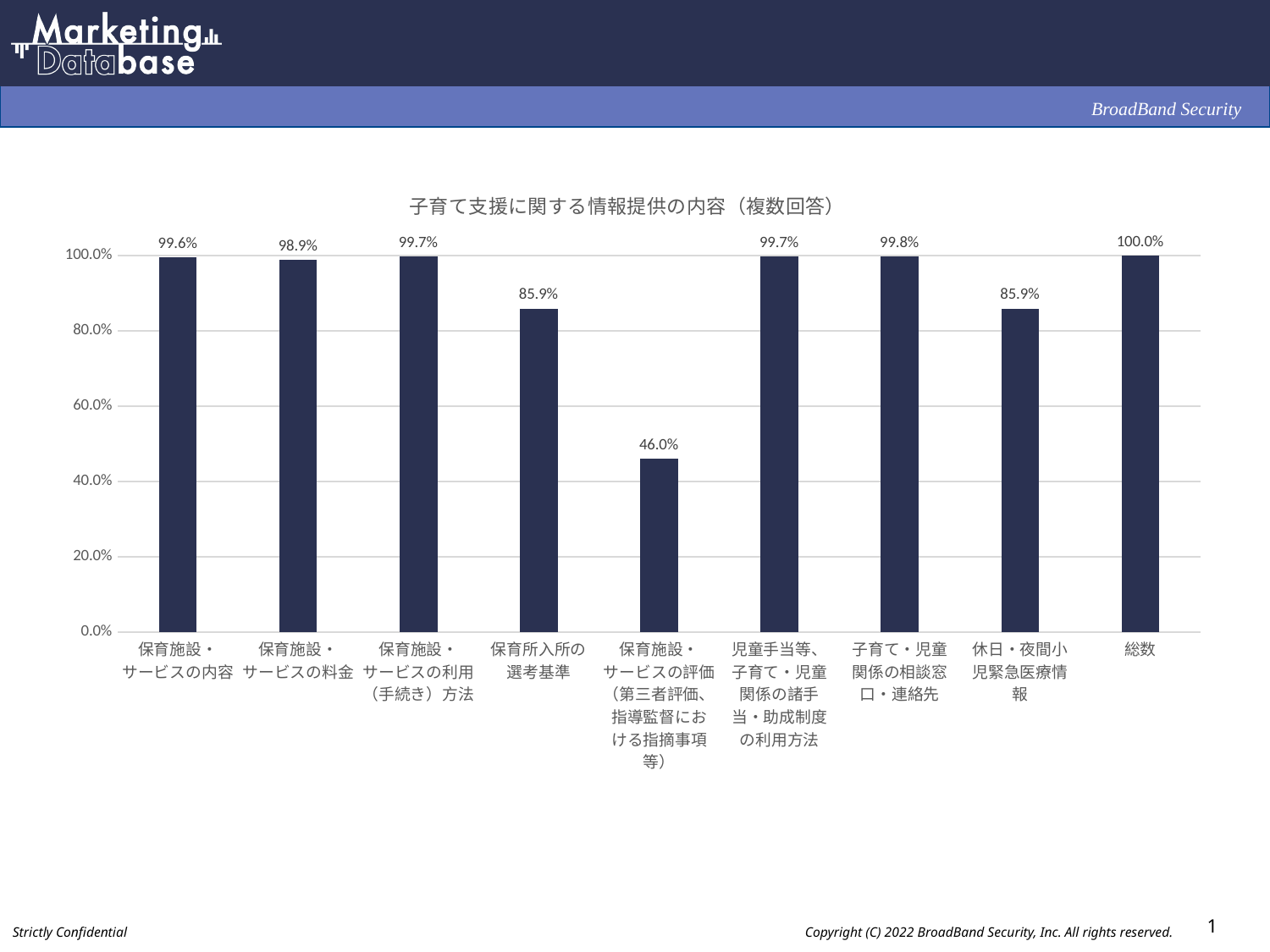
What is the value for 子育て・児童関係の相談窓口・連絡先? 99.8% Is the value for 保育施設・サービスの評価（第三者評価、指導監督における指摘事項等） greater or less than 60.0%? less Which category has the lowest value? 保育施設・サービスの評価（第三者評価、指導監督における指摘事項等） What is the difference between the value for 子育て・児童関係の相談窓口・連絡先 and the value for 休日・夜間小児緊急医療情報? 13.9% What is the difference between the value for 総数 and the value for 保育施設・サービスの評価（第三者評価、指導監督における指摘事項等）? 54.0% Which is larger, the value for 保育施設・サービスの料金 or the value for 保育所入所の選考基準? 保育施設・サービスの料金 How many categories are shown on the x axis? 9 What kind of chart is shown on the slide? bar chart What is the value for 保育所入所の選考基準? 85.9% What is the value for 保育施設・サービスの内容? 99.6% What is the value for 保育施設・サービスの料金? 98.9% Which category has the highest value? 総数